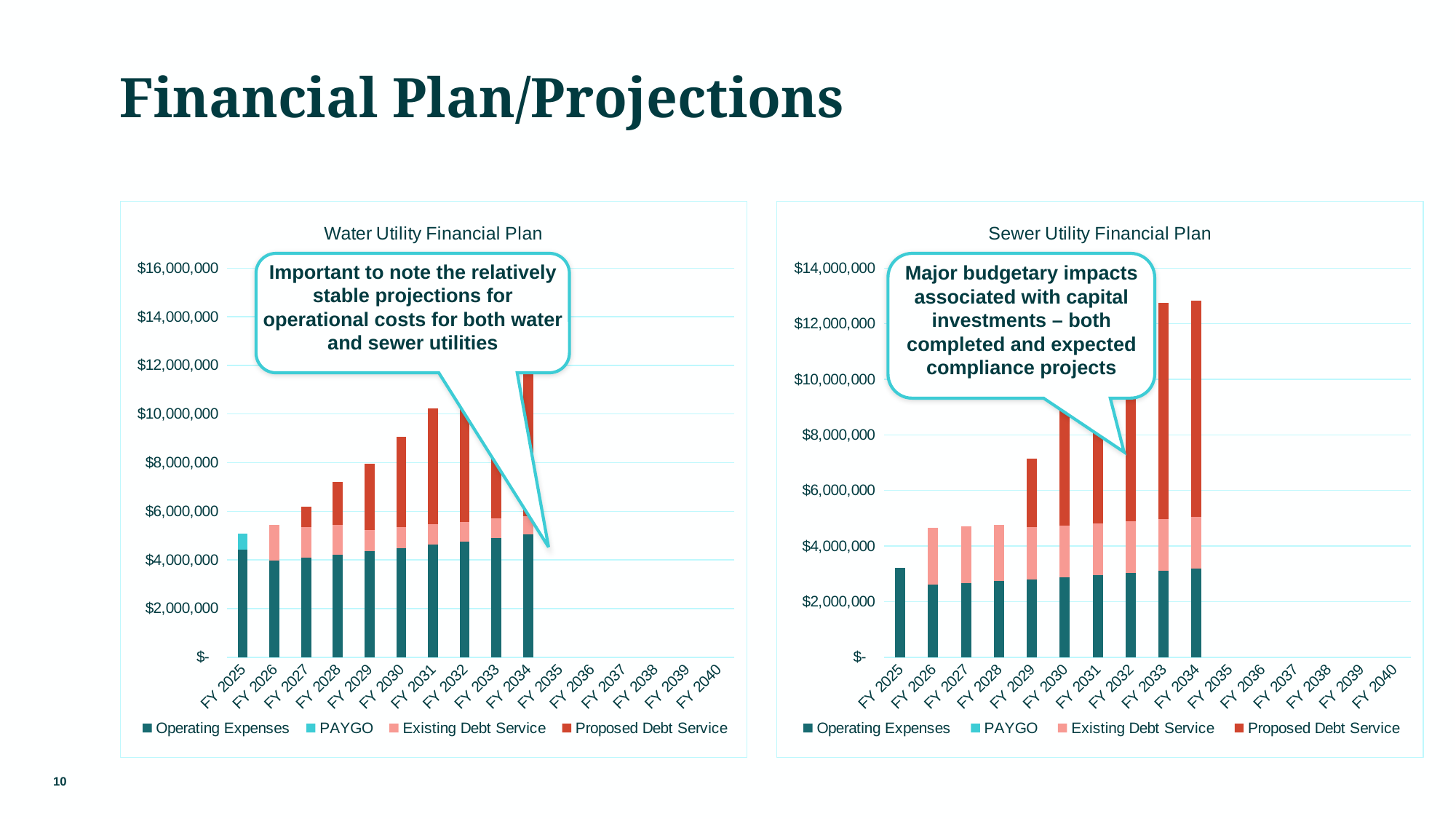
What type of chart is the Water Utility Financial Plan? Stacked bar chart In the Sewer Utility Financial Plan chart, which fiscal year has the shortest stacked bar? FY 2025 In the Water Utility Financial Plan chart, which fiscal year has the tallest stacked bar? FY 2034 What is the title of the chart on the right side of the slide? Sewer Utility Financial Plan In the Sewer Utility Financial Plan chart, is the total bar for FY 2034 greater or less than $12,000,000? greater In the Sewer Utility Financial Plan chart, do the total bar heights generally rise or fall from FY 2025 to FY 2034? rise In the Water Utility Financial Plan chart, is the total bar for FY 2030 greater or less than $8,000,000? greater In the Water Utility Financial Plan chart, which fiscal year is the only one showing a PAYGO segment? FY 2025 In the Sewer Utility Financial Plan chart, how many fiscal years have bars plotted? 10 In the Sewer Utility Financial Plan chart, is the total bar for FY 2025 greater or less than $4,000,000? less In the Water Utility Financial Plan chart, which has the taller total bar, FY 2027 or FY 2030? FY 2030 In the Water Utility Financial Plan chart, how many series does the legend list? 4